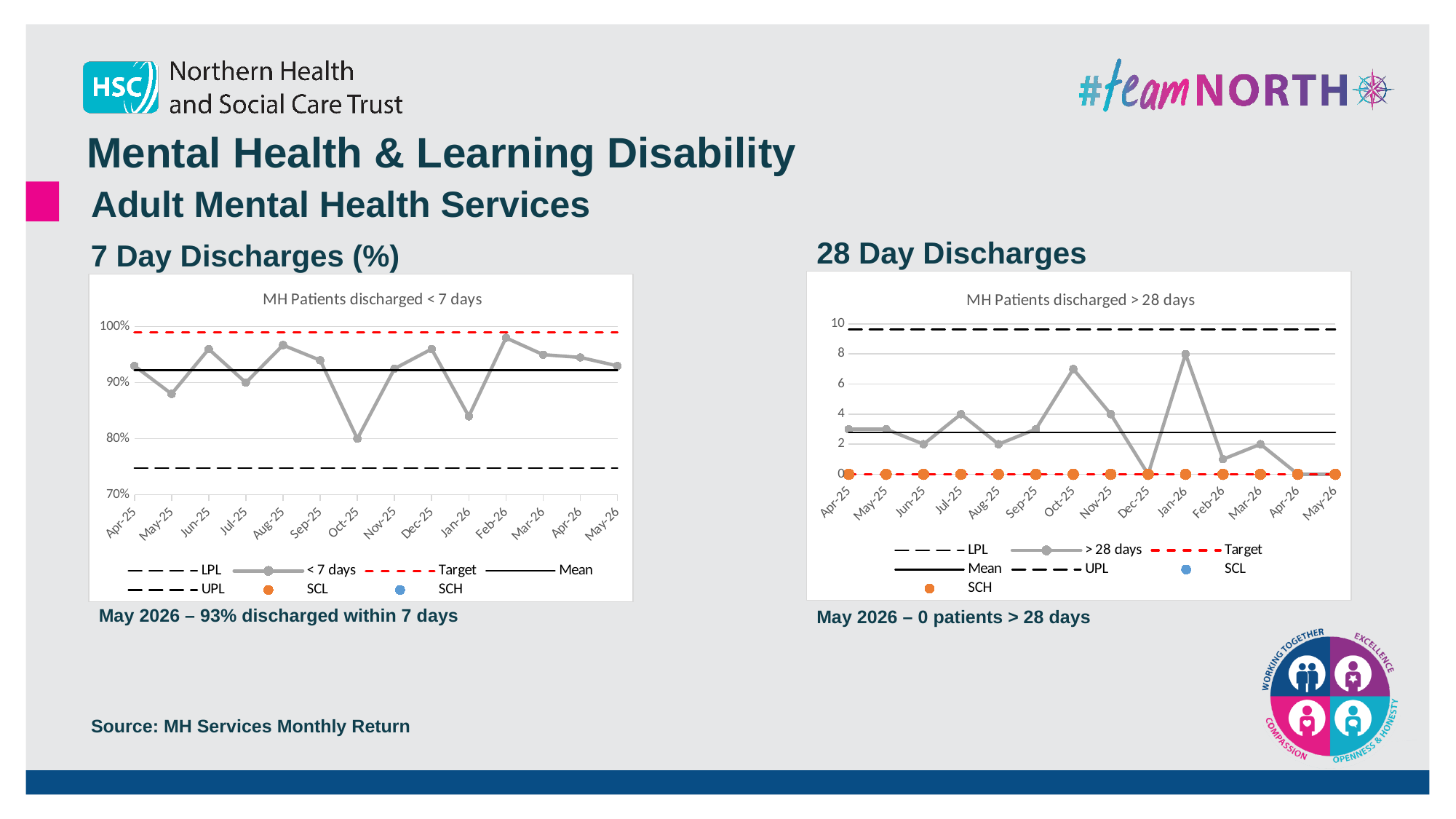
In the 'MH Patients discharged > 28 days' chart, is the value for Oct-25 greater or less than 6? greater In the 'MH Patients discharged < 7 days' chart, which month has the larger value: Feb-26 or Oct-25? Feb-26 In the 'MH Patients discharged < 7 days' chart, is the value for Oct-25 greater or less than 90%? less In the 'MH Patients discharged > 28 days' chart, what is the difference between the Jan-26 value and the Dec-25 value? 8 In the 'MH Patients discharged > 28 days' chart, what is the value for Jan-26? 8 In the 'MH Patients discharged < 7 days' chart, which month has the lowest value for the < 7 days series? Oct-25 How many entries does the legend of the 'MH Patients discharged < 7 days' chart list? 7 How many months are plotted on the x axis of the 'MH Patients discharged > 28 days' chart? 14 In the 'MH Patients discharged < 7 days' chart, what percentage of patients were discharged within 7 days in May-26? 93% What kind of chart is the 'MH Patients discharged < 7 days' chart? Line chart In the 'MH Patients discharged > 28 days' chart, how many patients were discharged after more than 28 days in May-26? 0 In the 'MH Patients discharged > 28 days' chart, which month has the highest value for the > 28 days series? Jan-26